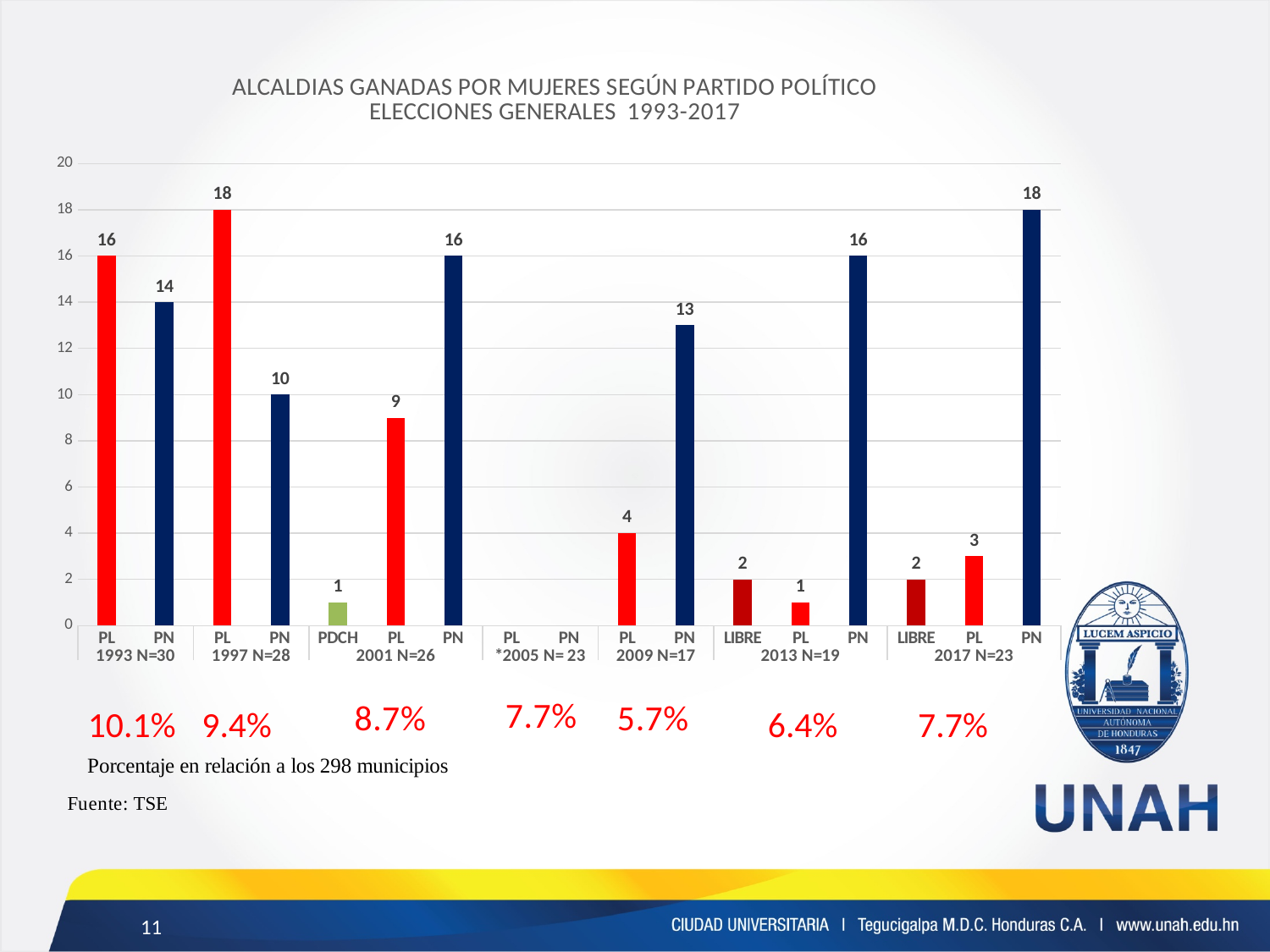
How many alcaldías did PL win in the 1993 election (N=30)? 16 What is the value for PN in the 1997 election (N=28)? 10 What is the difference between the PL and PN values in the 2009 election (N=17)? 9 What type of chart is shown on the slide? bar chart Which party has the highest value in the 2013 election group (N=19)? PN Which is larger: the PL value in 1993 or the PL value in 2001? PL in 1993 What is the value for PDCH in the 2001 election (N=26)? 1 Which party has the lowest value in the 2017 election group (N=23)? LIBRE What is the source cited below the chart? TSE Is the value for PN in 2001 greater or less than 10? greater What is the value for PN in the 2017 election (N=23)? 18 How many election years are shown along the x axis? 7